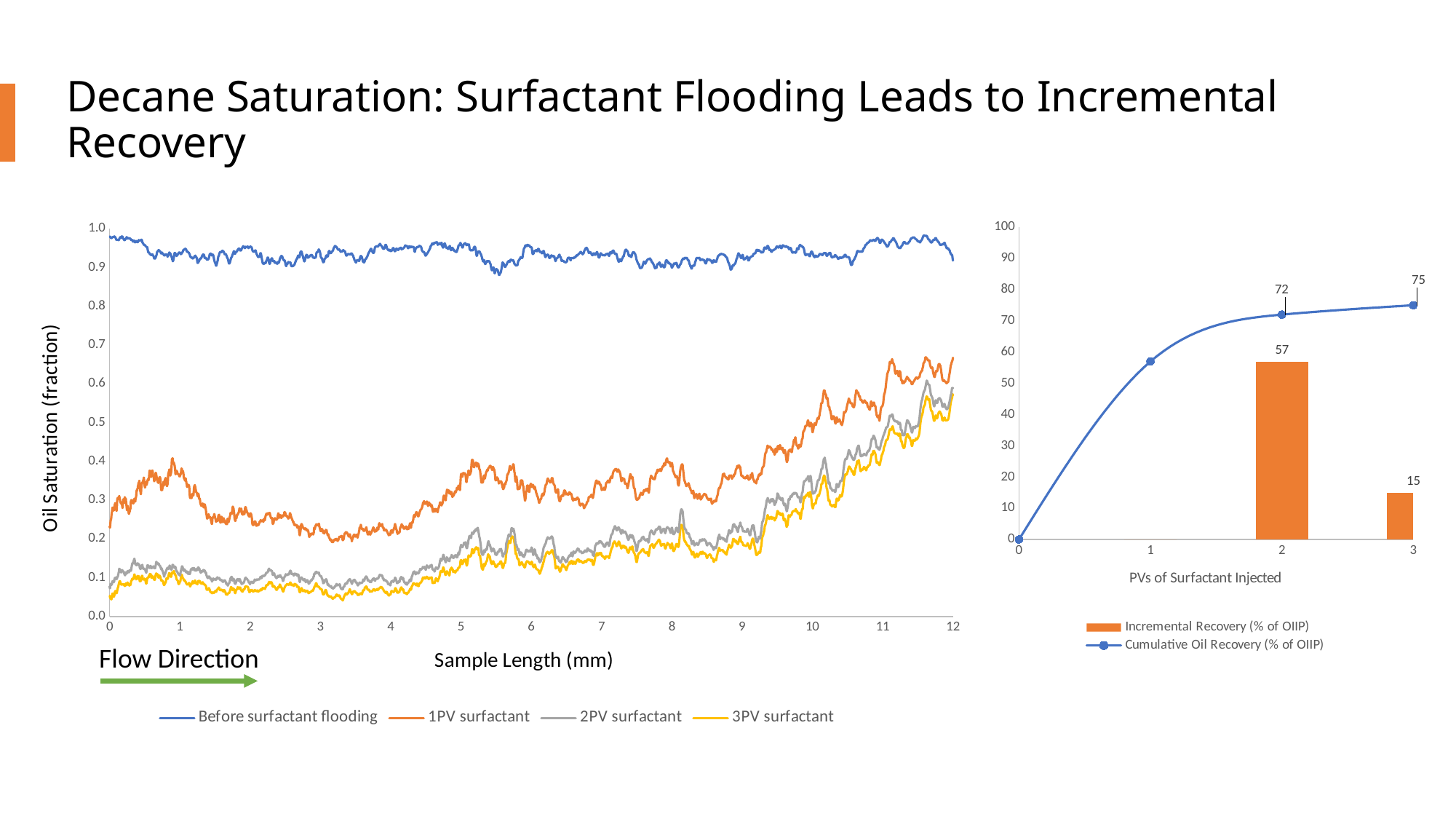
On the right chart, what is the Cumulative Oil Recovery (% of OIIP) at 3 PVs of surfactant injected? 75 On the right chart, what is the difference between the Incremental Recovery at 2 PVs and at 3 PVs? 42 On the right chart, what is the Cumulative Oil Recovery (% of OIIP) at 2 PVs of surfactant injected? 72 What kind of chart is the left chart showing Oil Saturation (fraction) against Sample Length (mm)? line chart On the right chart, what is the Incremental Recovery (% of OIIP) at 2 PVs of surfactant injected? 57 On the right chart, what is the Incremental Recovery (% of OIIP) at 3 PVs of surfactant injected? 15 On the left chart, how many series does the legend list? 4 On the right chart, by how much does Cumulative Oil Recovery increase from 2 PVs to 3 PVs? 3 On the right chart, which has the larger Incremental Recovery bar, 2 PVs or 3 PVs? 2 PVs On the right chart, how many series does the legend list? 2 On the left chart, is the Oil Saturation for 'Before surfactant flooding' at a sample length of 6 mm greater or less than 0.8? greater On the right chart, does the Cumulative Oil Recovery line rise or fall as PVs of Surfactant Injected increases? rise